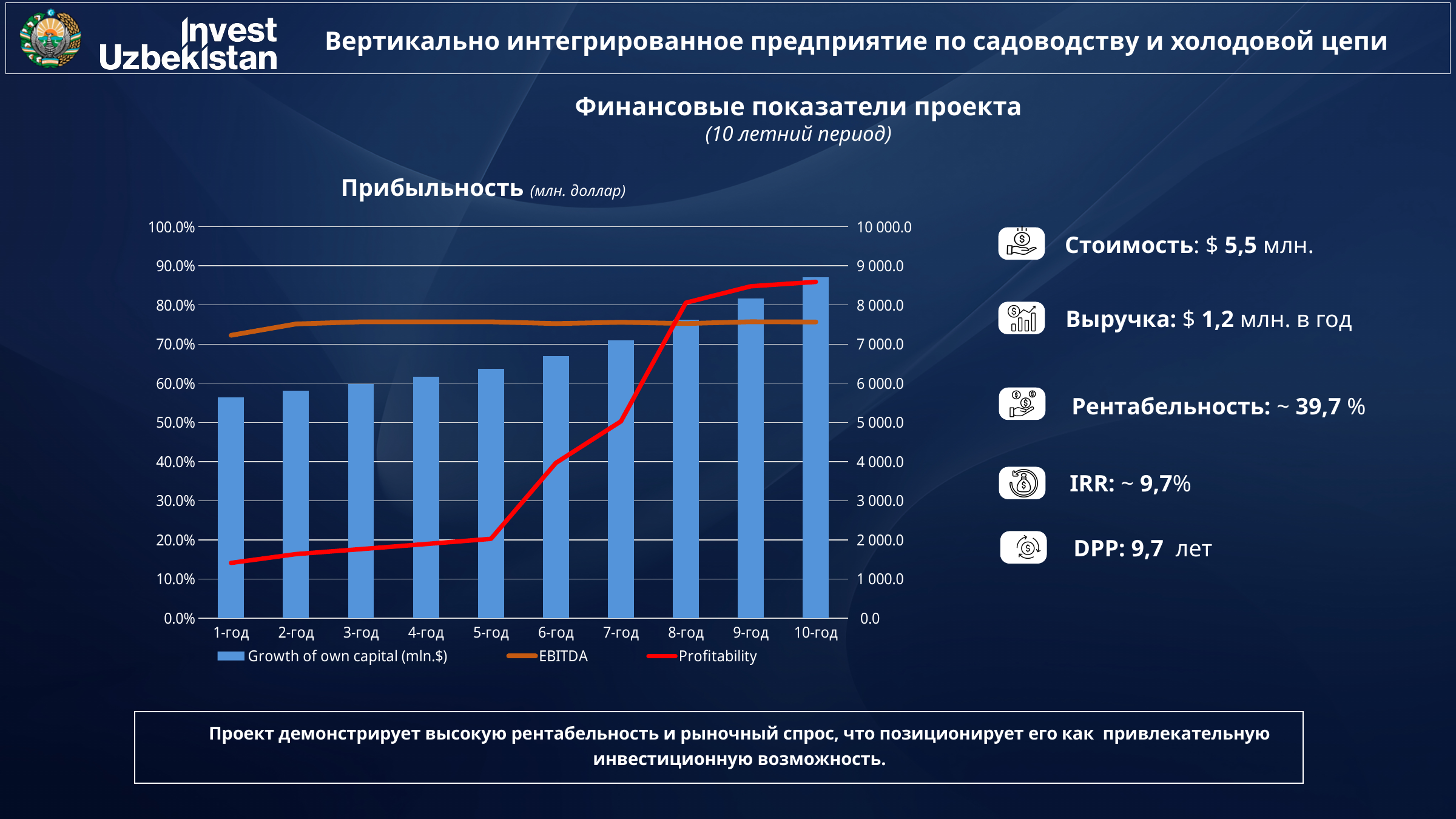
Do the Growth of own capital bars rise or fall from 1-год to 10-год? rise Which year has the highest bar for Growth of own capital? 10-год How many year categories are shown on the x axis of the chart? 10 Which year has the lowest bar for Growth of own capital? 1-год What is the title of the chart? Прибыльность (млн. доллар) Is the Profitability line value for 5-год greater or less than 30.0%? less Which bar is taller: 9-год or 2-год? 9-год What kind of chart is shown on the slide? bar chart with line series Is the Growth of own capital bar for 1-год greater or less than 60.0%? less How many series does the chart legend list? 3 Is the Growth of own capital bar for 10-год greater or less than 80.0%? greater